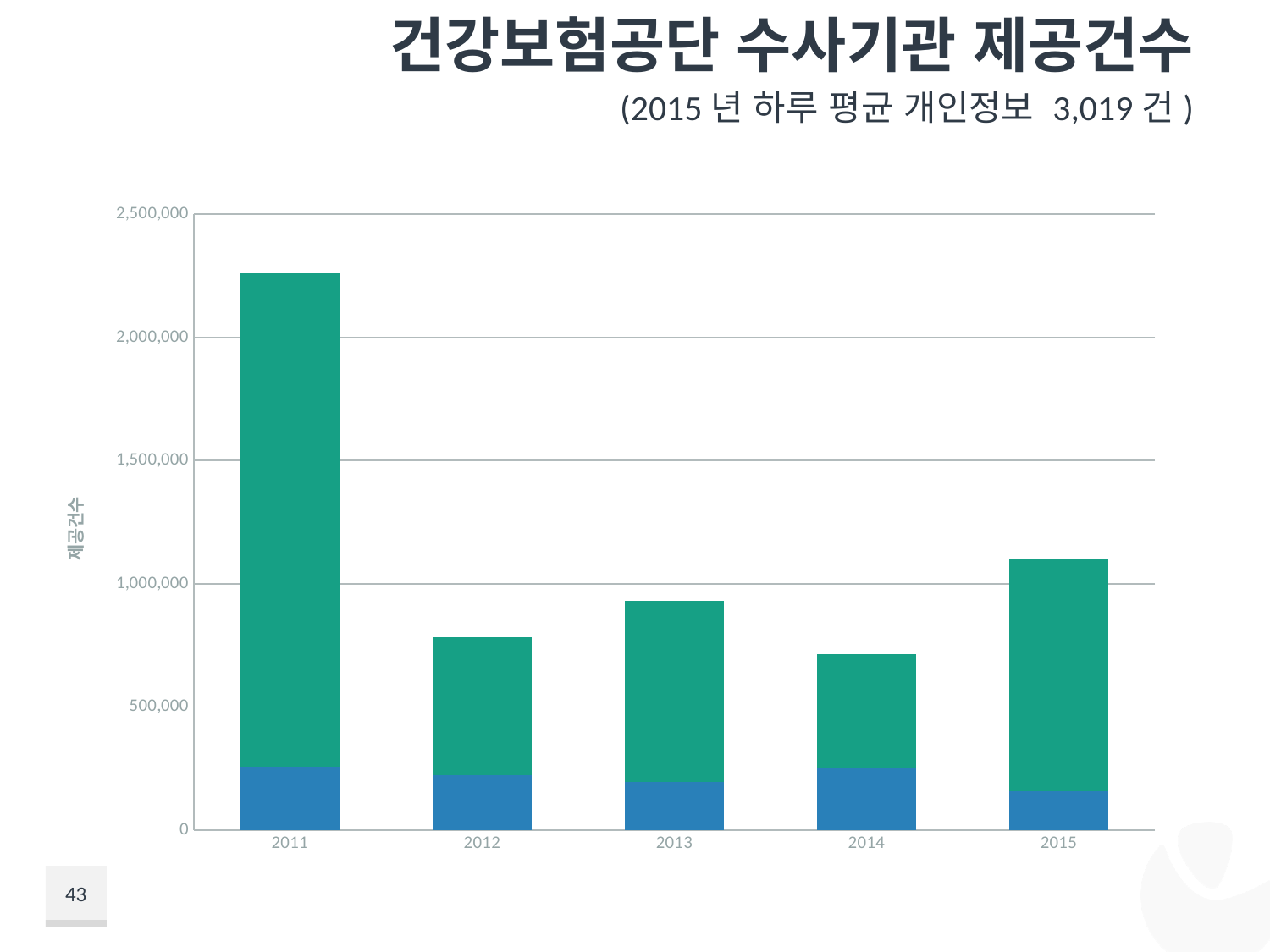
Which year has the taller bar, 2013 or 2014? 2013 Does the total bar height rise or fall from 2011 to 2012? fall Which year has the tallest bar in the chart? 2011 Which year has the taller bar, 2015 or 2012? 2015 Is the total bar height for 2011 greater or less than 2,000,000? greater Which year has the shortest bar in the chart? 2014 What is the label on the vertical axis of the chart? 제공건수 Is the total bar height for 2012 greater or less than 1,000,000? less Is the total bar height for 2015 greater or less than 1,000,000? greater What kind of chart is shown on the slide? stacked bar chart How many years are shown on the x axis of the chart? 5